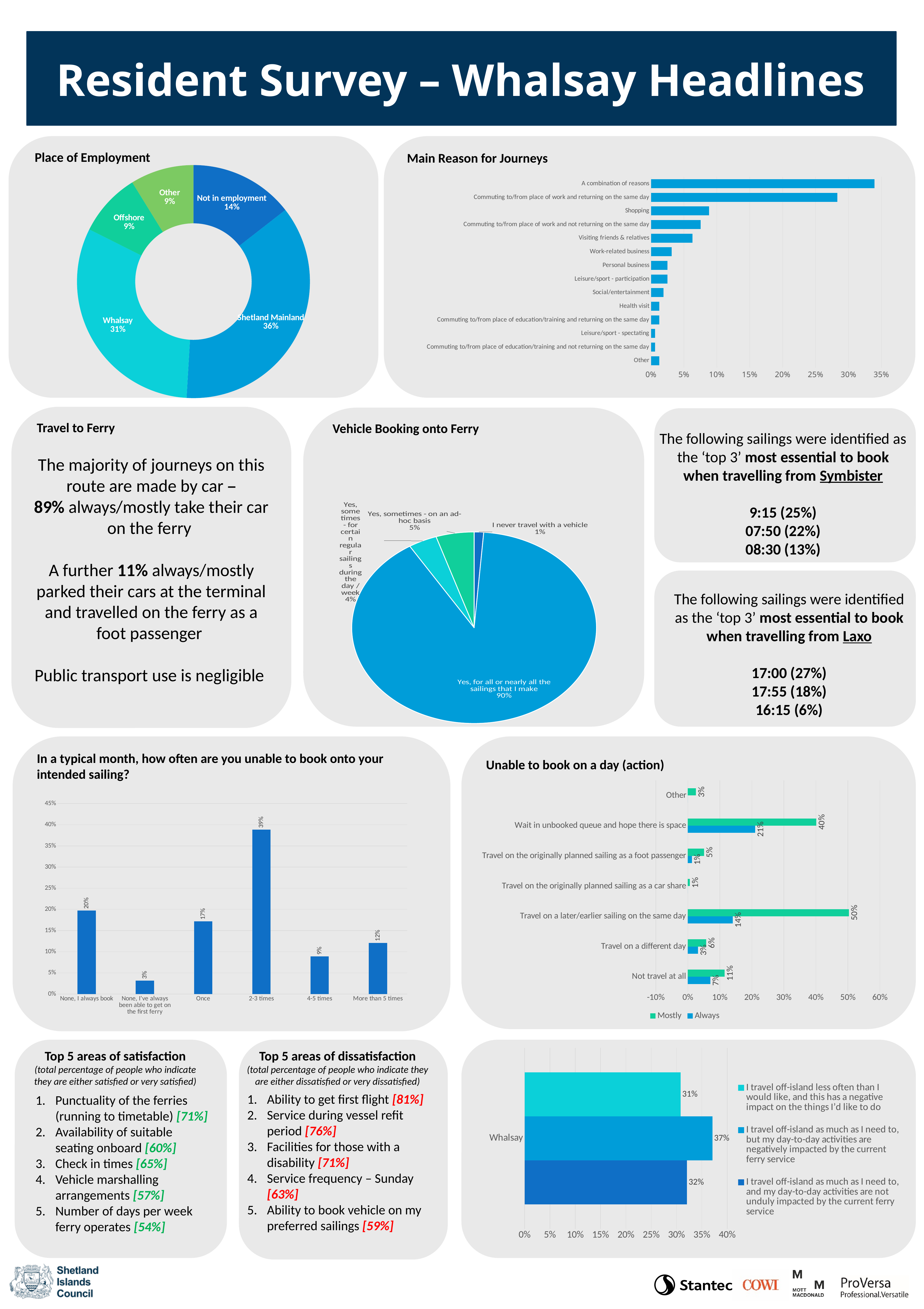
In the Unable to book on a day (action) chart, what is the Mostly value for 'Travel on a later/earlier sailing on the same day'? 50% In the Vehicle Booking onto Ferry pie chart, what share of respondents answered 'Yes, for all or nearly all the sailings that I make'? 90% In the Main Reason for Journeys chart, which reason has the highest value? A combination of reasons In the Place of Employment chart, what percentage of respondents work on Shetland Mainland? 36% In the chart 'In a typical month, how often are you unable to book onto your intended sailing?', how many categories are shown on the x axis? 6 In the Place of Employment chart, what is the difference between the Whalsay and Not in employment shares? 17% In the Unable to book on a day (action) chart, how many series does the legend list? 2 In the chart 'In a typical month, how often are you unable to book onto your intended sailing?', what is the value for 2-3 times? 39% What kind of chart is the Main Reason for Journeys chart? Bar chart In the bottom-right bar chart for Whalsay, which is larger: the value for 'I travel off-island less often than I would like' (31%) or 'I travel off-island as much as I need to, but my day-to-day activities are negatively impacted' (37%)? I travel off-island as much as I need to, but my day-to-day activities are negatively impacted (37%) In the Main Reason for Journeys chart, is the value for Shopping greater or less than 5%? greater In the Place of Employment chart, which category has the largest share? Shetland Mainland